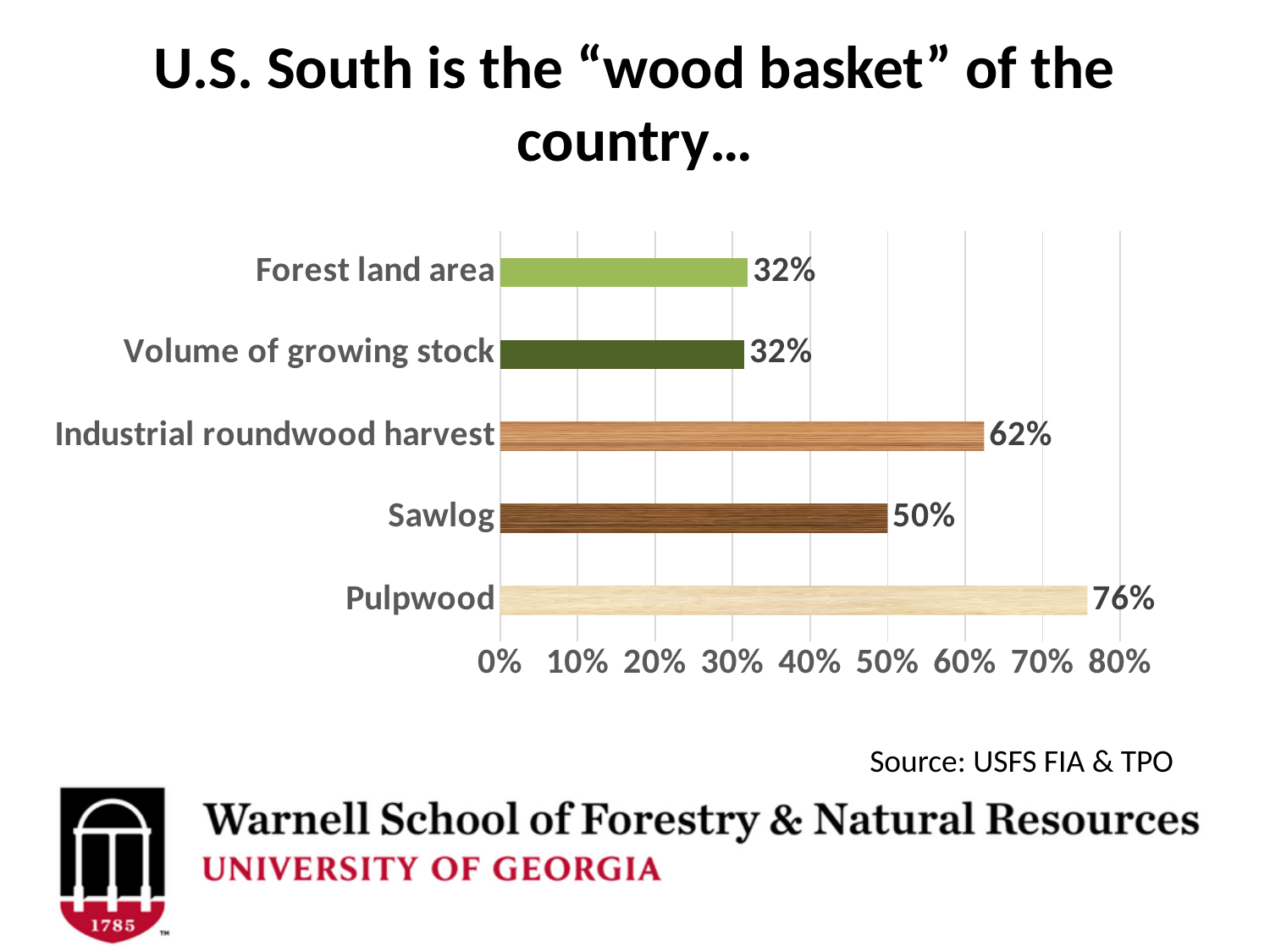
What kind of chart is shown on the slide? Bar chart Which is larger, the value for Industrial roundwood harvest or the value for Sawlog? Industrial roundwood harvest Which category has the highest value? Pulpwood What is the value for Forest land area? 32% What is the value for Sawlog? 50% What is the value for Industrial roundwood harvest? 62% What is the source cited below the chart? USFS FIA & TPO Is the value for Sawlog greater or less than 40%? greater How many categories are shown in the chart? 5 What is the difference between the values for Pulpwood and Sawlog? 26% What is the value for Pulpwood? 76% What is the difference between the values for Industrial roundwood harvest and Forest land area? 30%